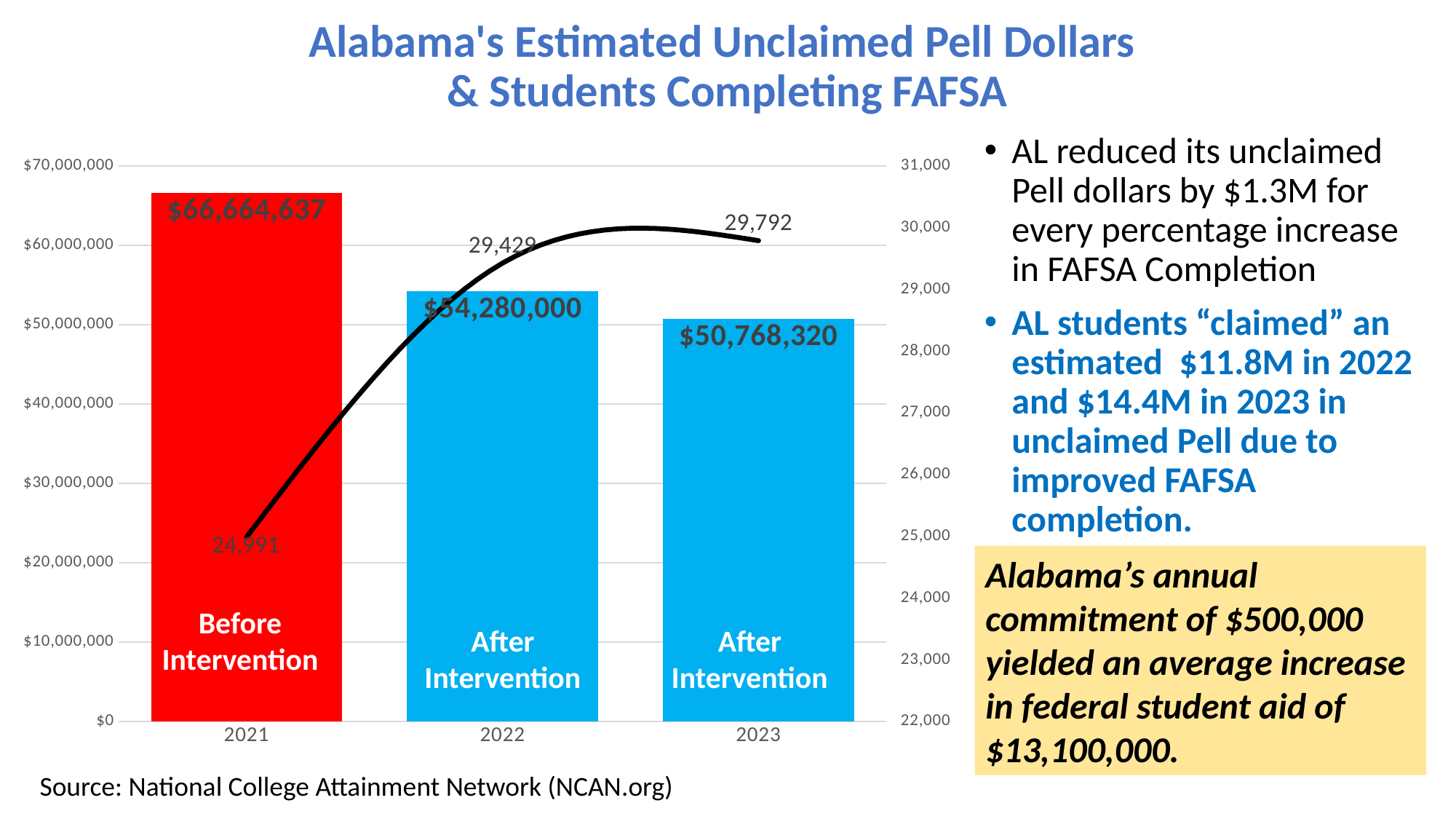
How many more students completed FAFSA in 2023 than in 2022? 363 Which bar is coloured red? 2021 (Before Intervention) What is the difference in unclaimed Pell dollars between 2021 and 2022? $12,384,637 How many students completed FAFSA in 2021 according to the line? 24,991 What is the estimated unclaimed Pell dollar value for 2021? $66,664,637 How many students completed FAFSA in 2022 according to the line? 29,429 What is the estimated unclaimed Pell dollar value for 2023? $50,768,320 Do the unclaimed Pell dollar bars rise or fall from 2021 to 2023? fall How many years are shown on the x axis of the chart? 3 Which year has the highest estimated unclaimed Pell dollars? 2021 Which year has more unclaimed Pell dollars, 2022 or 2023? 2022 Which year has the lowest number of students completing FAFSA? 2021